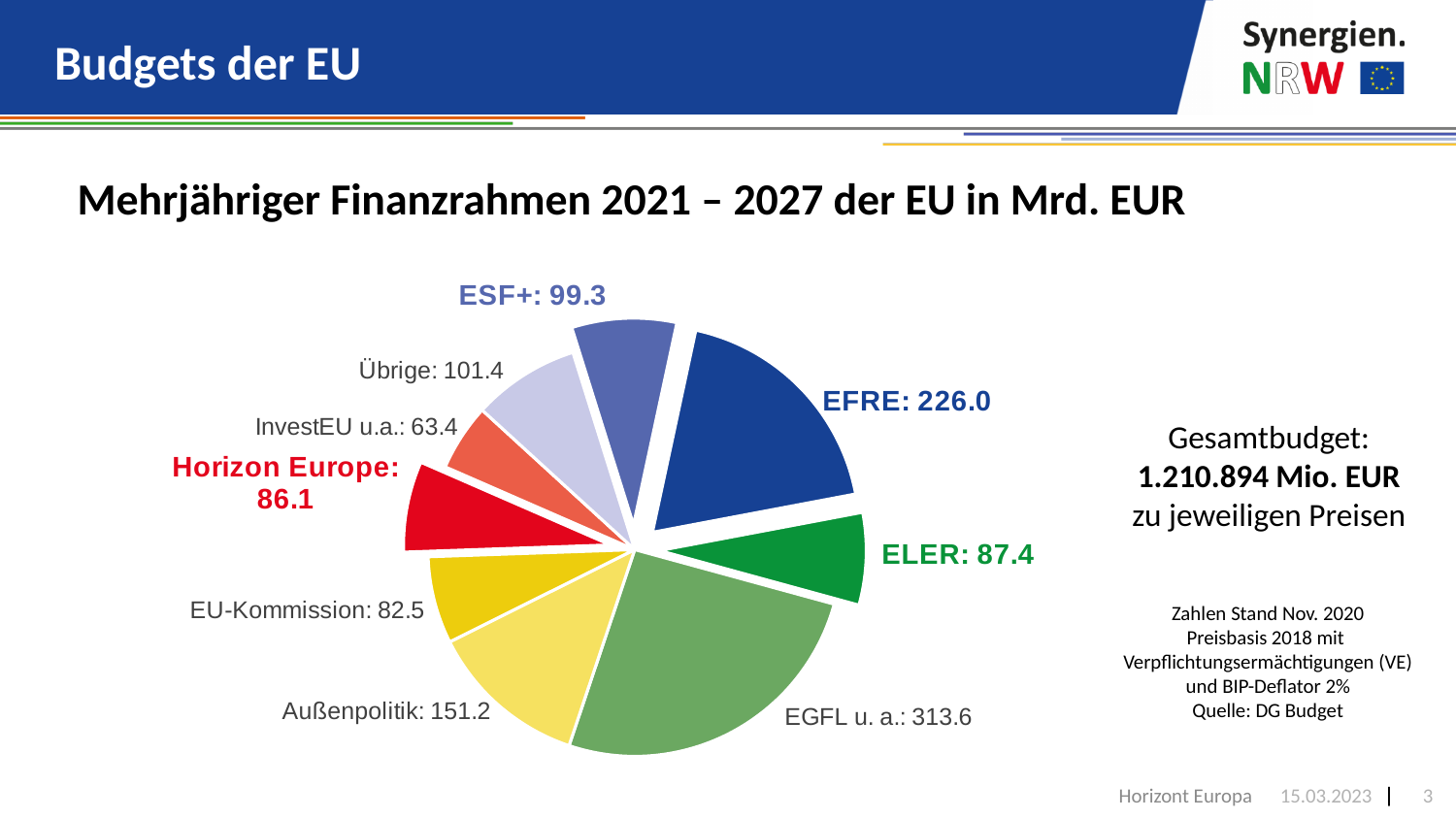
Which is larger, the value for Übrige or the value for ESF+? Übrige What kind of chart is shown on the slide? pie chart What is the title of the chart on the slide? Mehrjähriger Finanzrahmen 2021 – 2027 der EU in Mrd. EUR What is the difference between the values for EGFL u. a. and EFRE? 87.6 How many slices does the pie chart have? 9 What is the value for Horizon Europe in the pie chart? 86.1 What is the value for EFRE in the pie chart? 226.0 Which category has the smallest slice in the pie chart? InvestEU u.a. Which category has the largest slice in the pie chart? EGFL u. a. What is the value for Außenpolitik in the pie chart? 151.2 Which is larger, the value for Außenpolitik or the value for EU-Kommission? Außenpolitik What is the difference between the values for EFRE and ELER? 138.6